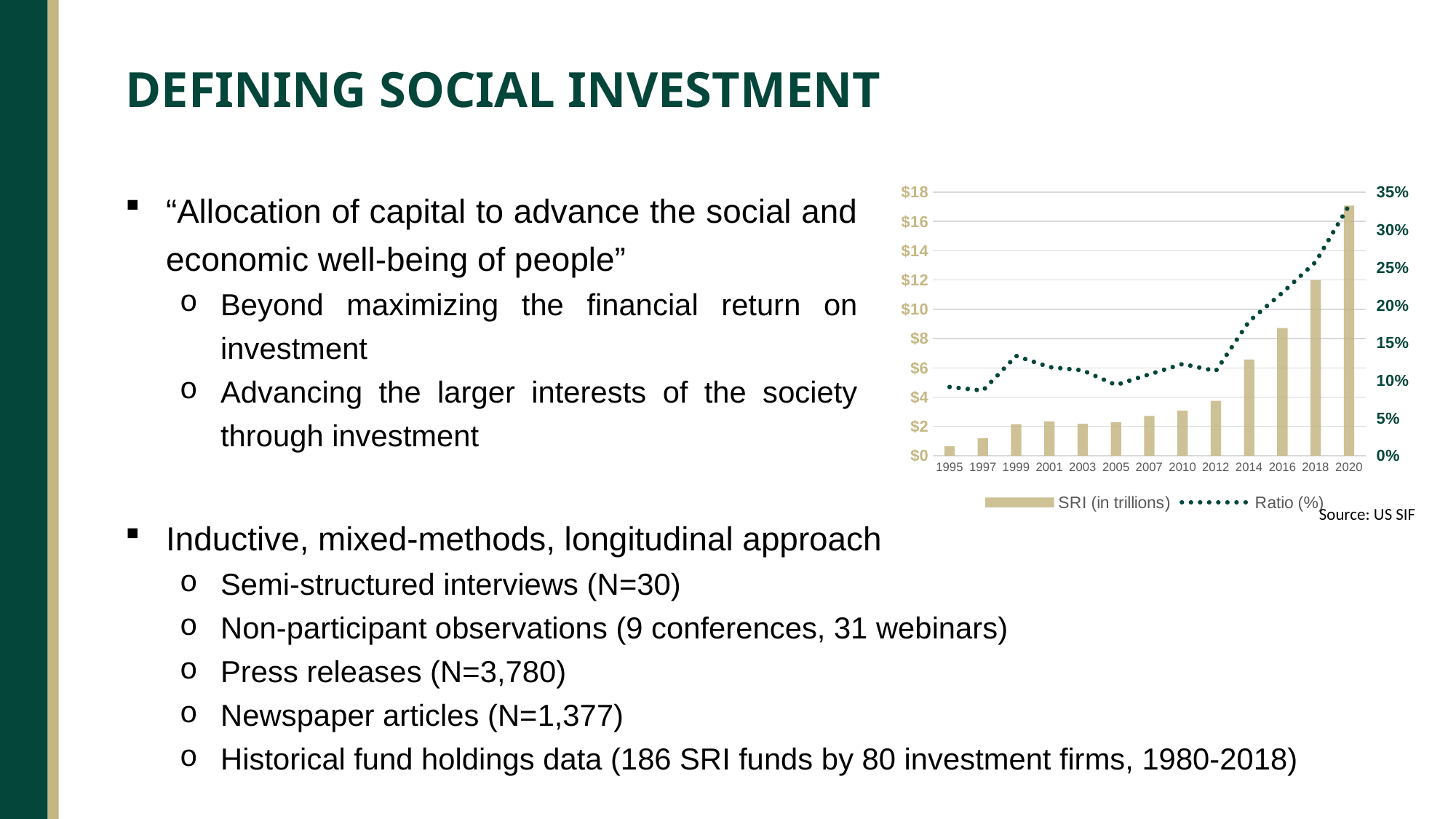
Which year has a larger SRI (in trillions) bar, 2016 or 2012? 2016 Which year has the highest SRI (in trillions) bar? 2020 In which year does the Ratio (%) line reach its highest point? 2020 Is the Ratio (%) value for 2020 greater or less than 30%? greater How many series does the chart legend list? 2 What kind of chart is shown on the slide? Bar chart with a dotted line What source is cited for the chart? US SIF Is the SRI (in trillions) value for 2020 greater or less than $16? greater Do the SRI (in trillions) bars generally rise or fall from 1995 to 2020? Rise Which year has the lowest SRI (in trillions) bar? 1995 How many years are shown on the x axis of the chart? 13 Is the SRI (in trillions) value for 1995 greater or less than $2? less